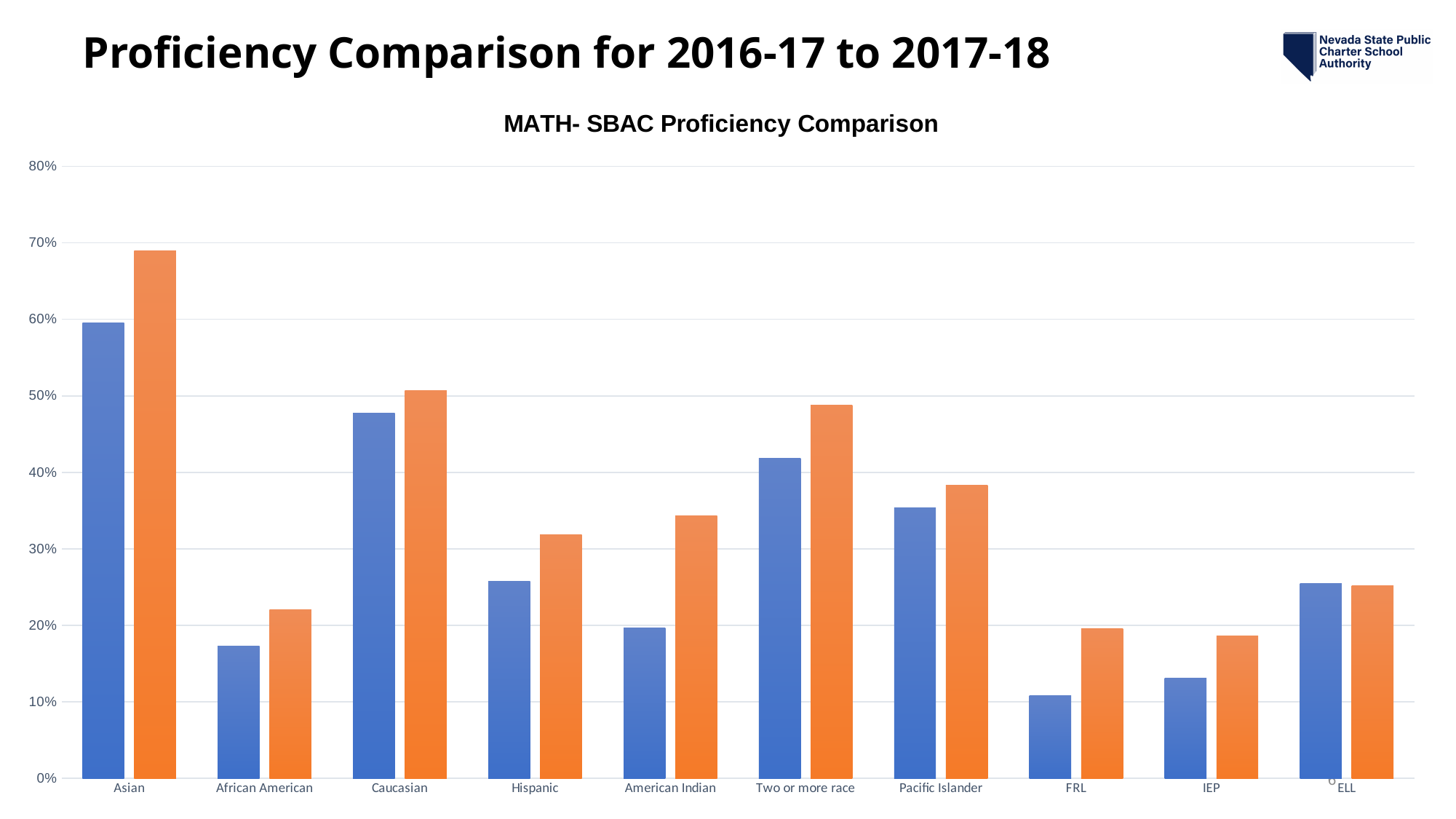
Is the value of the orange bar for Asian greater or less than 60%? greater What is the title of the chart? MATH- SBAC Proficiency Comparison For the Asian category, which bar is taller, the blue one or the orange one? orange Which category has the tallest orange bar? Asian Which has the taller blue bar, Caucasian or Hispanic? Caucasian How many categories are shown on the x axis of the chart? 10 Which category has the shortest blue bar? FRL Is the value of the blue bar for IEP greater or less than 20%? less Is the value of the blue bar for Two or more race greater or less than 40%? greater What kind of chart is shown on the slide? bar chart